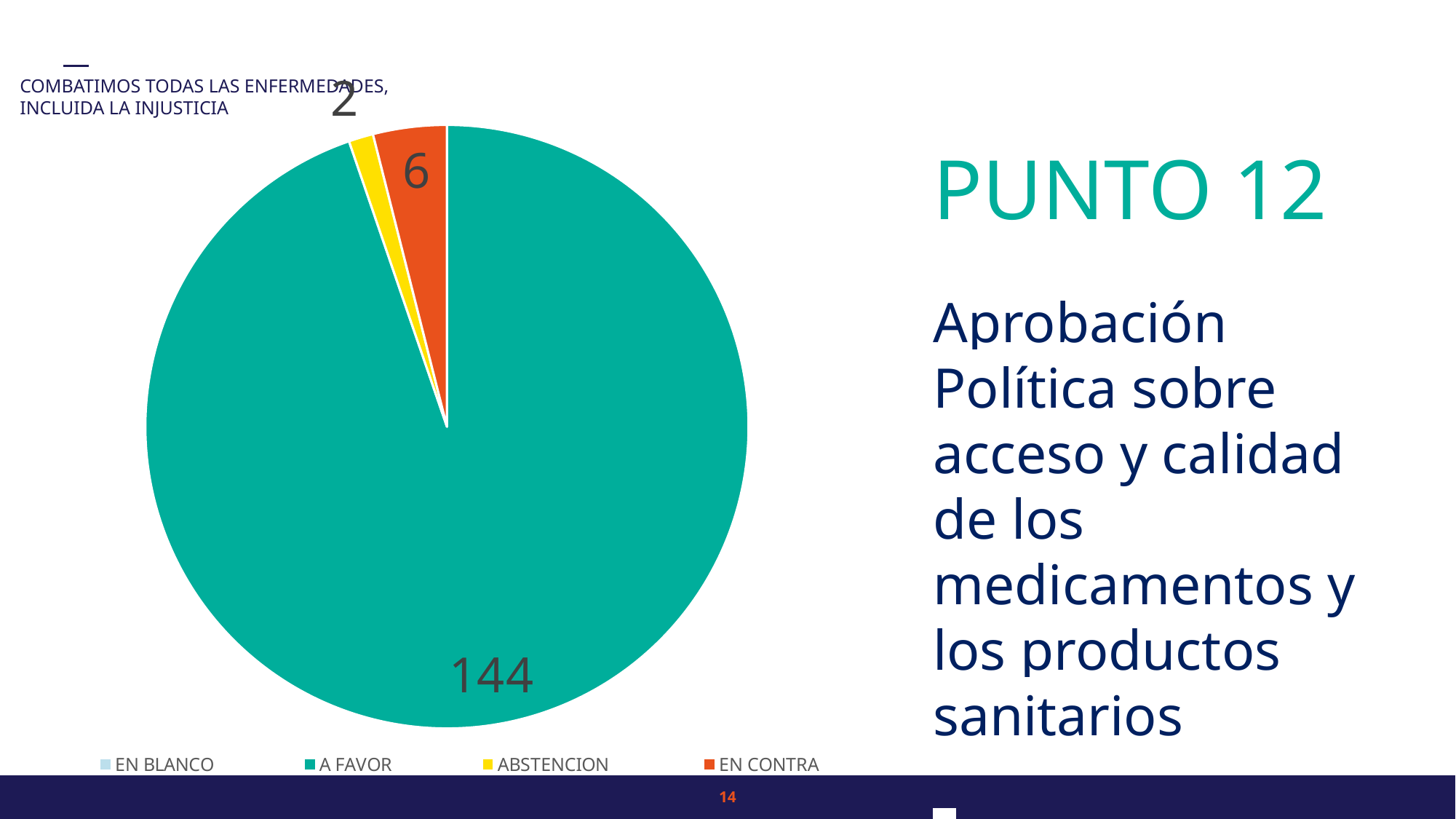
What colour is used for the EN CONTRA slice in the pie chart? orange What is the value for ABSTENCION in the pie chart? 2 What is the value for EN CONTRA in the pie chart? 6 Which is larger, the A FAVOR slice or the EN CONTRA slice? A FAVOR What is the difference between the EN CONTRA value and the ABSTENCION value? 4 Which category has the largest slice in the pie chart? A FAVOR How many categories does the legend of the pie chart list? 4 Which is larger, the EN CONTRA slice or the ABSTENCION slice? EN CONTRA What is the difference between the A FAVOR value and the EN CONTRA value? 138 What is the value for A FAVOR in the pie chart? 144 What colour is used for the A FAVOR slice in the pie chart? teal What type of chart is shown on the slide? pie chart